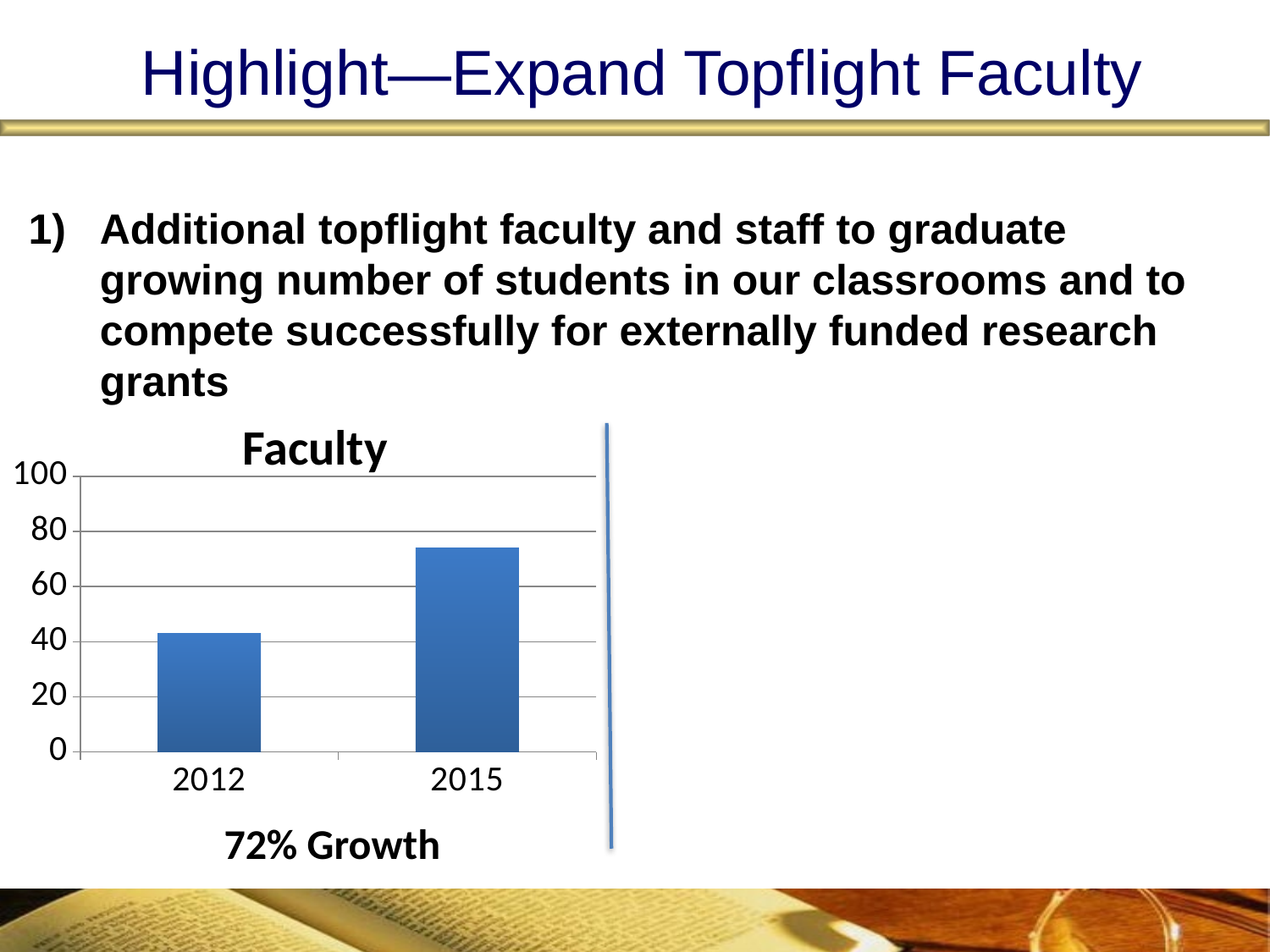
Is the value for 2012 greater or less than 60? less How many categories are shown on the x axis of the Faculty chart? 2 Is the value for 2012 greater or less than 20? greater What kind of chart is shown on the slide? bar chart Is the value for 2015 greater or less than 60? greater Do the values rise or fall from 2012 to 2015 in the Faculty chart? rise What is the title of the chart? Faculty Which year has the higher faculty value, 2012 or 2015? 2015 Which year has the lowest value in the Faculty chart? 2012 What growth percentage is stated below the Faculty chart? 72% Growth Which year has the highest value in the Faculty chart? 2015